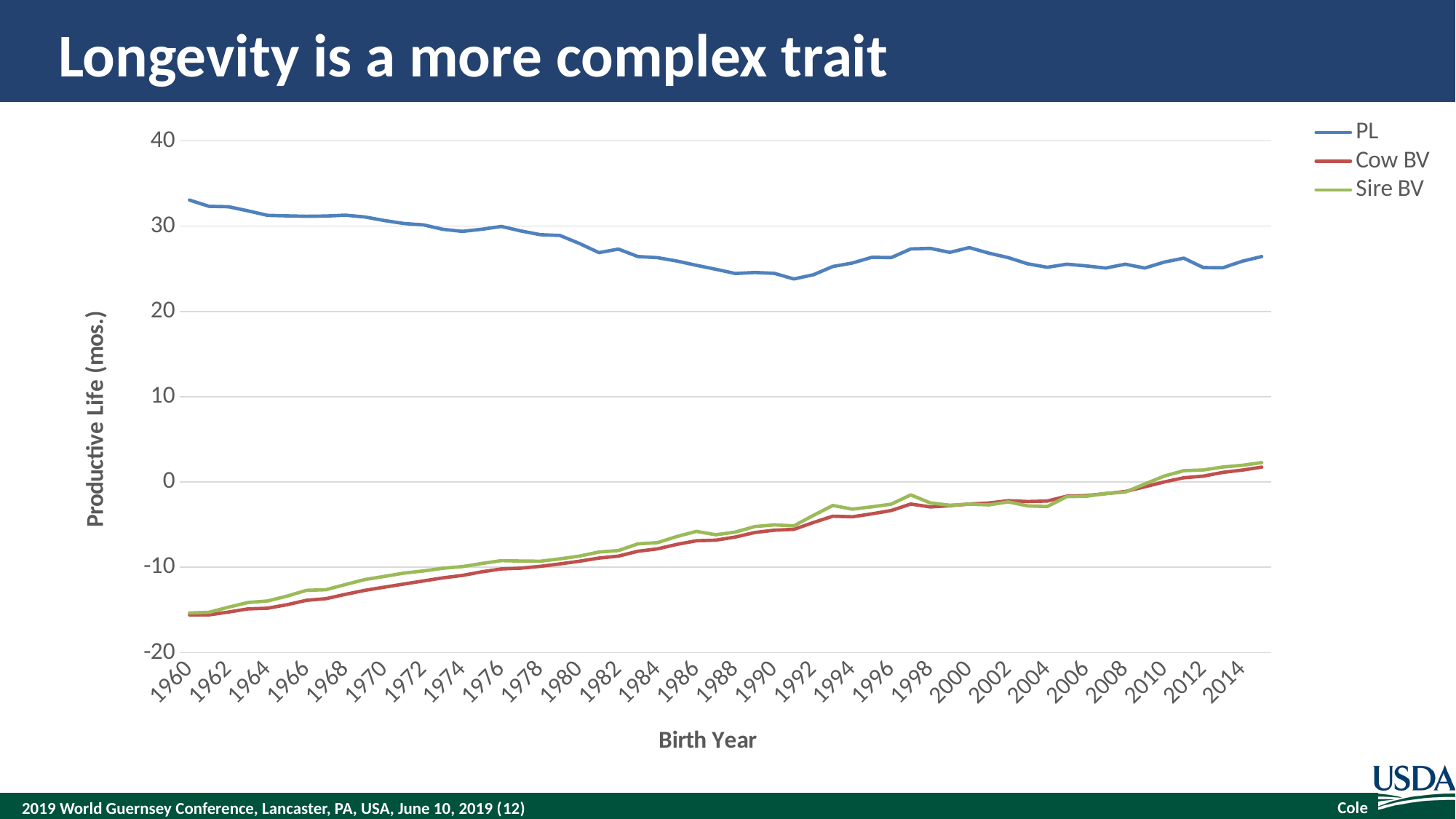
Is the Sire BV value for birth year 2014 greater or less than 0? greater Is the PL value for birth year 1960 greater or less than 30? greater Which series has the highest values across all birth years shown? PL How many series does the legend list? 3 What is the title of the vertical axis? Productive Life (mos.) Is the Cow BV value for birth year 1960 greater or less than -10? less What are the three series named in the legend? PL, Cow BV, Sire BV What kind of chart is shown on the slide? line chart Does the Cow BV series rise or fall across the birth years from 1960 to 2014? rise Does the PL series rise or fall from 1960 to 1992? fall For birth year 1960, which series has the higher value, PL or Cow BV? PL